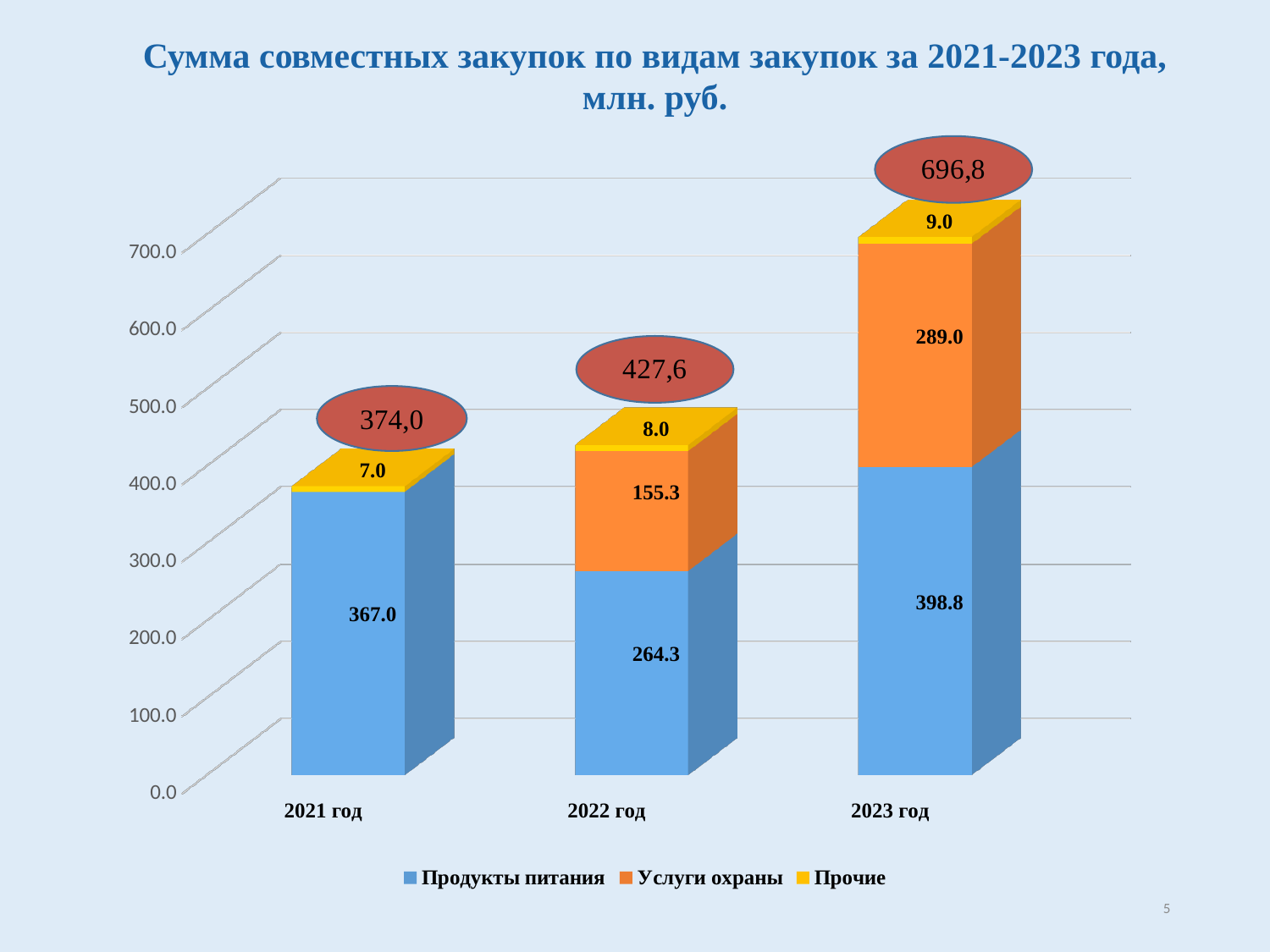
What is the difference between the Продукты питания values for 2023 год and 2022 год? 134.5 What is the value for Прочие in 2023 год? 9.0 What is the value for Услуги охраны in 2022 год? 155.3 Which is larger: Прочие in 2022 год or Прочие in 2021 год? Прочие in 2022 год Which year has the lowest value for Продукты питания? 2022 год What is the total shown for the 2021 год bar? 374,0 Which year has the highest value for Услуги охраны? 2023 год How many series does the legend list? 3 How many years are shown on the x axis? 3 What kind of chart is shown on the slide? Stacked bar chart What is the total shown for the 2023 год bar? 696,8 What is the value for Продукты питания in 2021 год? 367.0